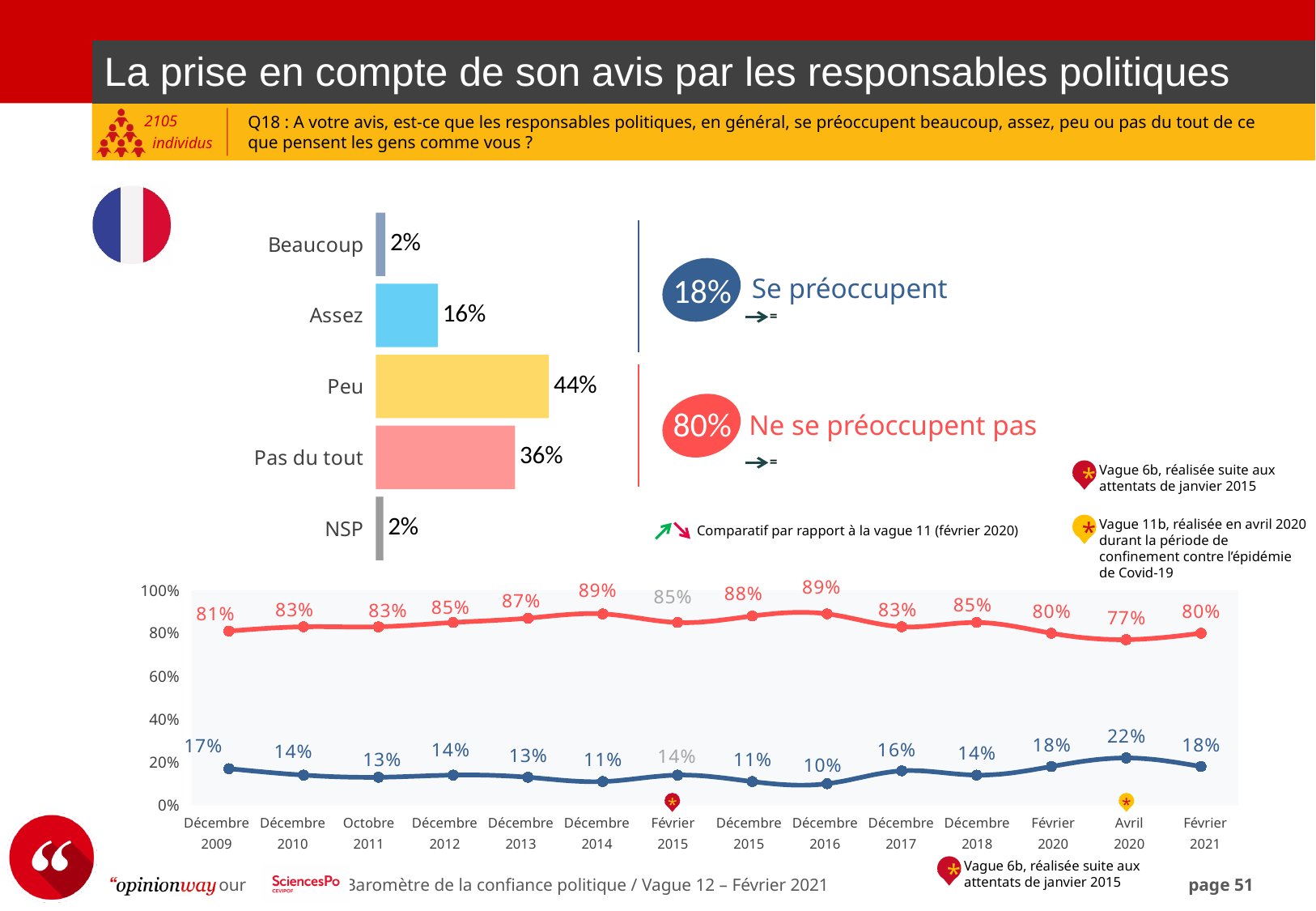
How many categories does the bar chart show? 5 In the bar chart, what is the difference between the values for "Peu" and "Pas du tout"? 8% In the bar chart, which category has the highest value? Peu In the line chart, what is the value of the blue line for Décembre 2016? 10% In the bar chart, what is the value for "Pas du tout"? 36% How many time points does the line chart show on the x axis? 14 In the bar chart, what is the value for "Peu"? 44% In the line chart, what is the difference between the red line values for Décembre 2016 and Février 2021? 9% In the line chart, at which time point does the blue line reach its highest value? Avril 2020 In the line chart, what is the value of the red line for Avril 2020? 77% What kind of chart is the chart at the bottom of the slide? Line chart In the bar chart, which is larger, the value for "Assez" or the value for "Beaucoup"? Assez